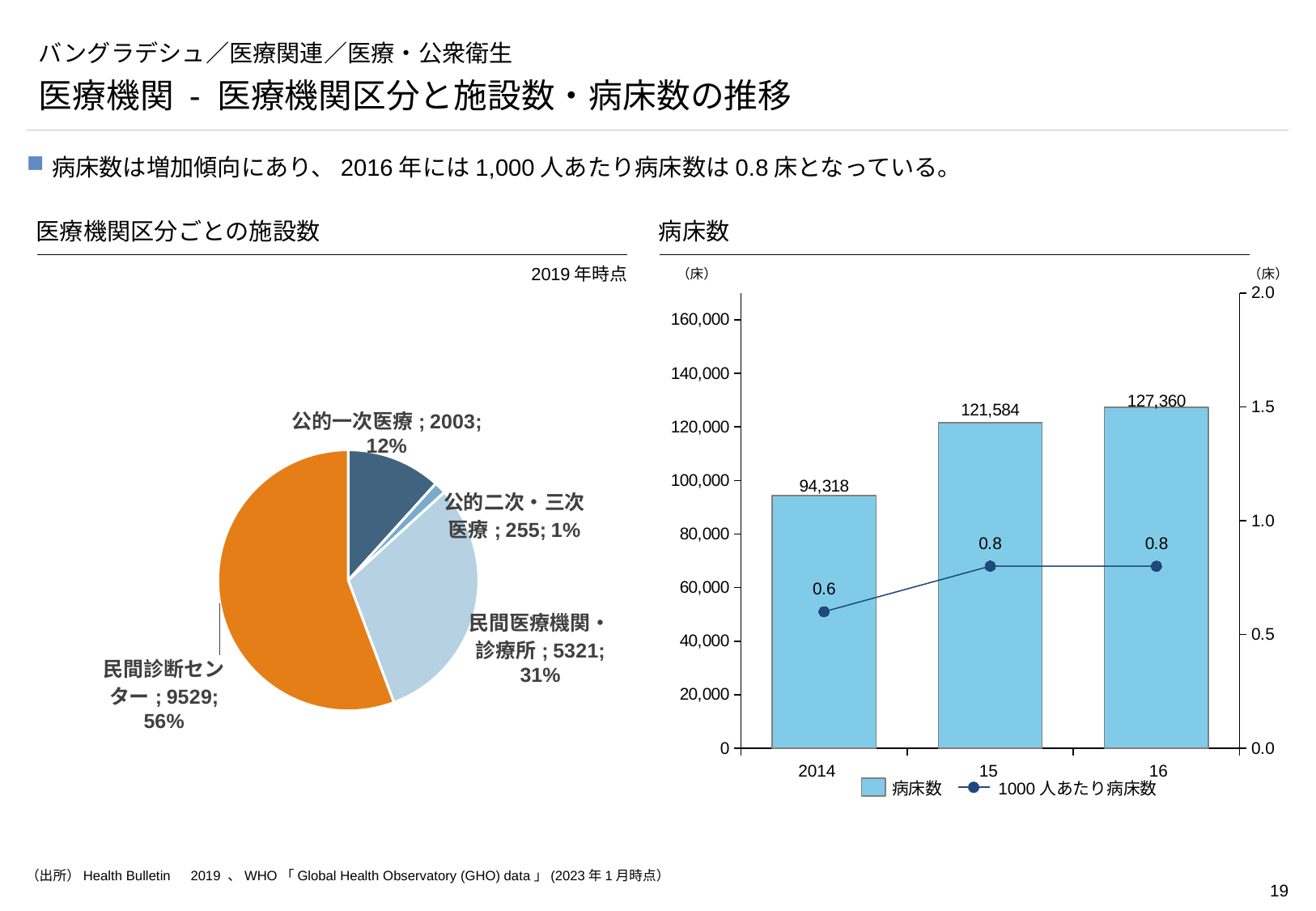
In the 医療機関区分ごとの施設数 pie chart, which category has the smallest share? 公的二次・三次医療 What kind of chart is the 医療機関区分ごとの施設数 chart? pie chart In the 医療機関区分ごとの施設数 pie chart, what share does 民間医療機関・診療所 have? 31% In the 病床数 chart, what is the number of hospital beds (病床数) in 2016? 127,360 In the 病床数 chart, how many series does the legend list? 2 In the 病床数 chart, what is the difference in hospital beds between 2015 and 2014? 27,266 In the 病床数 chart, which year has the highest number of hospital beds? 2016 In the 医療機関区分ごとの施設数 pie chart, how many categories are shown? 4 In the 病床数 chart, what is the number of hospital beds (病床数) in 2014? 94,318 In the 病床数 chart, do the hospital bed numbers rise or fall from 2014 to 2016? rise In the 病床数 chart, what is the value of 1000人あたり病床数 in 2014? 0.6 In the 医療機関区分ごとの施設数 pie chart, what is the number of facilities for 民間診断センター? 9529